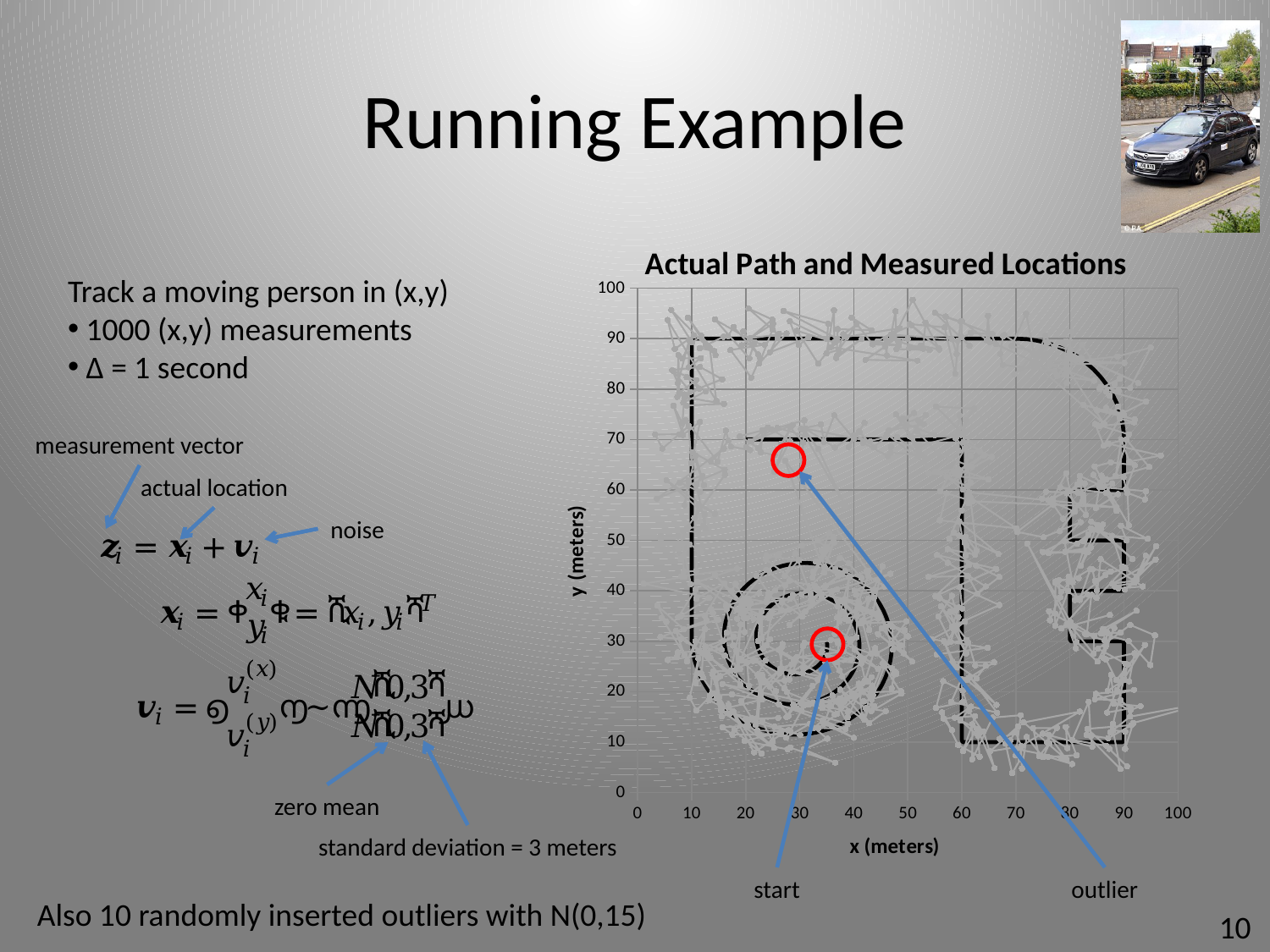
What is the title of the chart on the slide? Actual Path and Measured Locations What kind of chart is shown on the slide? scatter chart What does the lower red circle on the chart mark? start Is the largest x value reached by the actual path greater or less than 80? greater Is the lowest y value reached by the actual path greater or less than 20? less Is the highest y value reached by the actual path greater or less than 80? greater How many (x,y) measurements are plotted on the chart? 1000